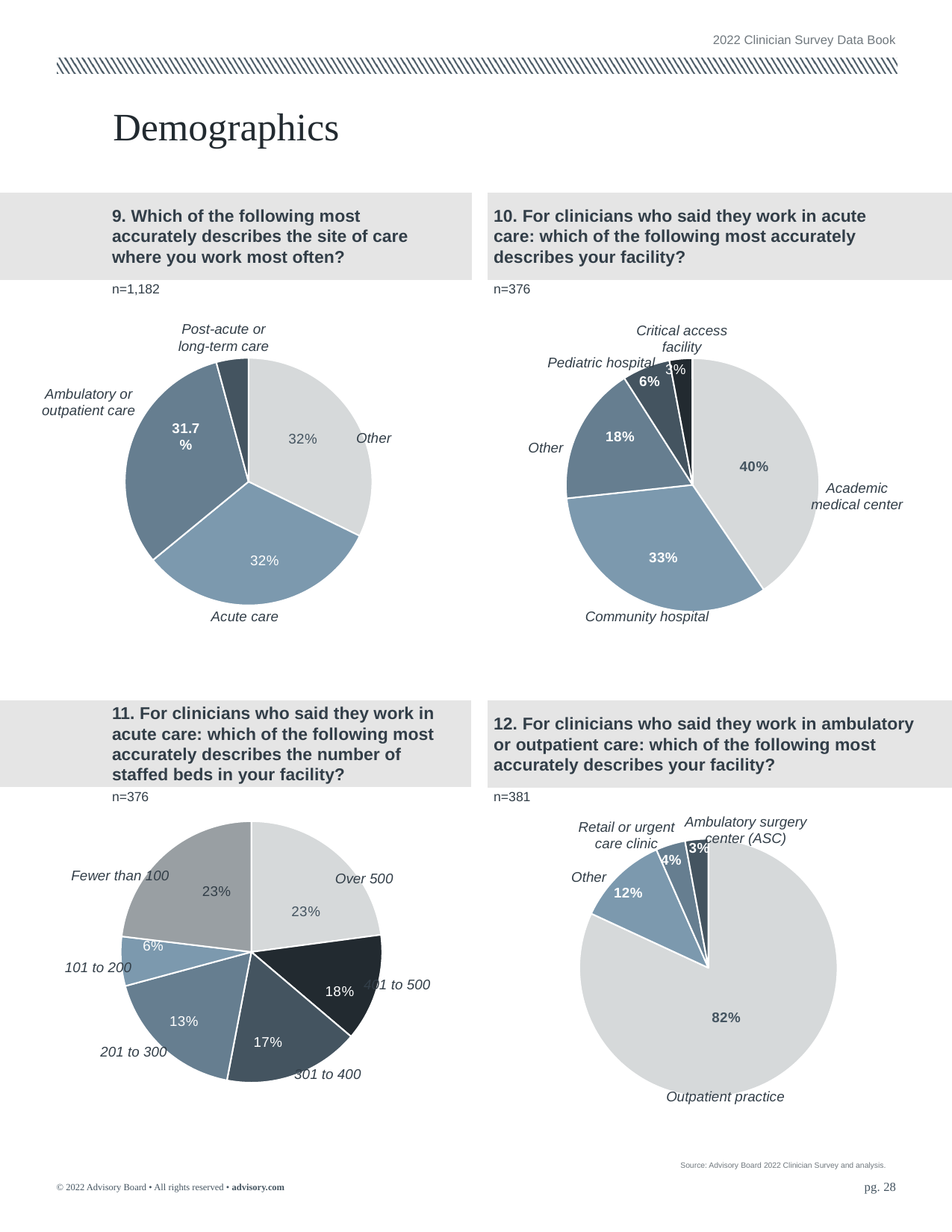
In the chart for question 11 (number of staffed beds), which bed-count category has the smallest share? 101 to 200 In the chart for question 11 (number of staffed beds), what percentage of clinicians work in a facility with 301 to 400 staffed beds? 17% In the chart for question 9 (site of care), which is larger: the share for Acute care or the share for Post-acute or long-term care? Acute care What type of chart is used for question 10 (acute care facility type)? Pie chart What is the sample size (n) shown for the chart for question 9 (site of care)? n=1,182 In the chart for question 11 (number of staffed beds), how many bed-count categories are shown? 6 In the chart for question 12 (ambulatory or outpatient facility type), what percentage of clinicians work in an outpatient practice? 82% In the chart for question 9 (site of care), what percentage of clinicians work in ambulatory or outpatient care? 31.7% In the chart for question 10 (acute care facility type), what percentage of clinicians work at a community hospital? 33% In the chart for question 10 (acute care facility type), what percentage of clinicians work at an academic medical center? 40% In the chart for question 12 (ambulatory or outpatient facility type), what is the difference in percentage points between Outpatient practice and Other? 70 In the chart for question 10 (acute care facility type), which facility type has the smallest share? Critical access facility